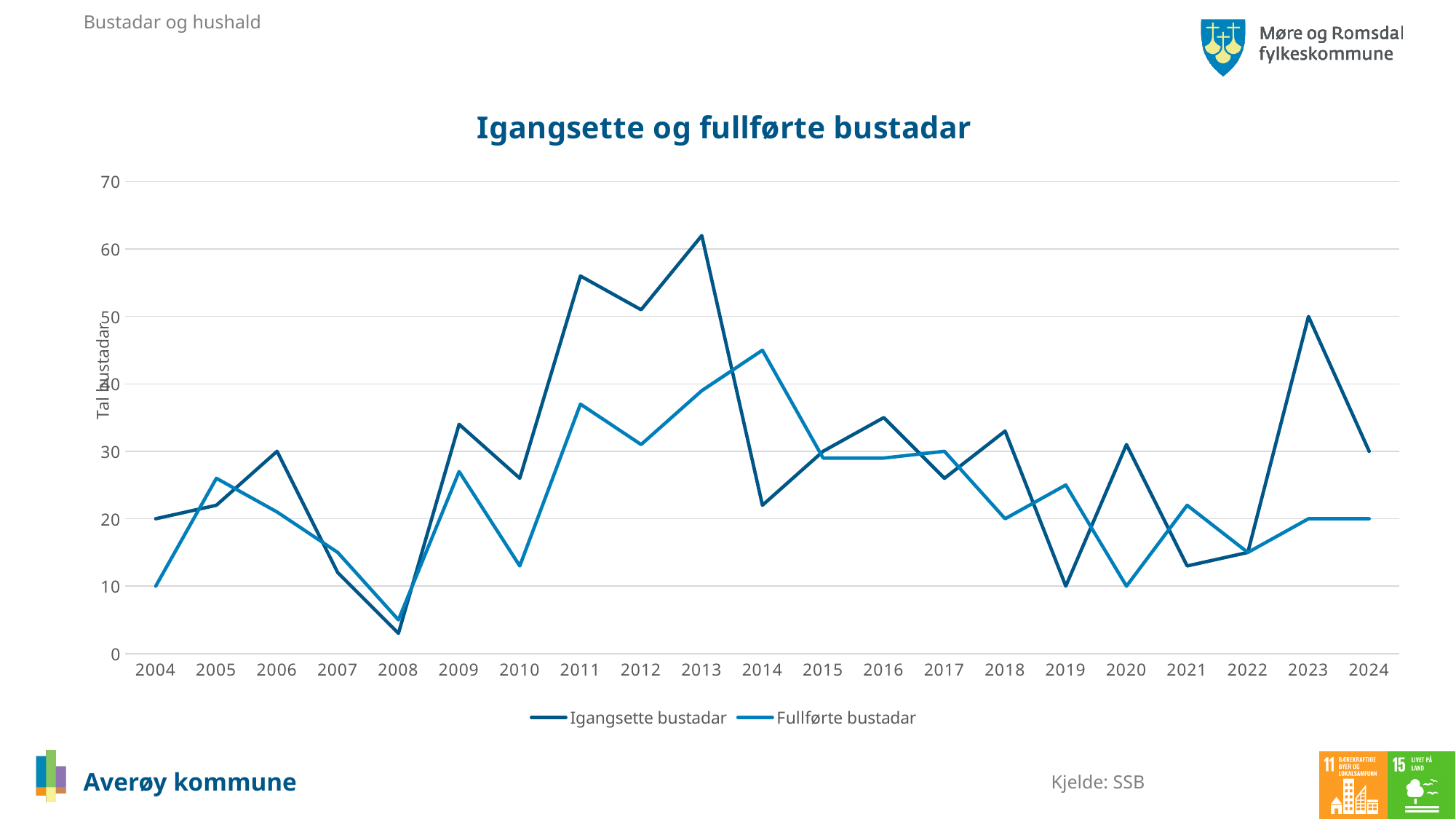
Is the value for Fullførte bustadar in 2010 greater or less than 20? less What is the source given for the chart data? SSB What is the title of the chart? Igangsette og fullførte bustadar In which year does the Igangsette bustadar series reach its lowest value? 2008 In which year does the Igangsette bustadar series reach its highest value? 2013 In 2014, which series has the larger value, Igangsette bustadar or Fullførte bustadar? Fullførte bustadar Is the value for Igangsette bustadar in 2013 greater or less than 60? greater How many years are shown on the x axis? 21 How many series does the legend list? 2 In which year does the Fullførte bustadar series reach its highest value? 2014 Is the value for Fullførte bustadar in 2014 greater or less than 40? greater What kind of chart is shown on the slide? line chart